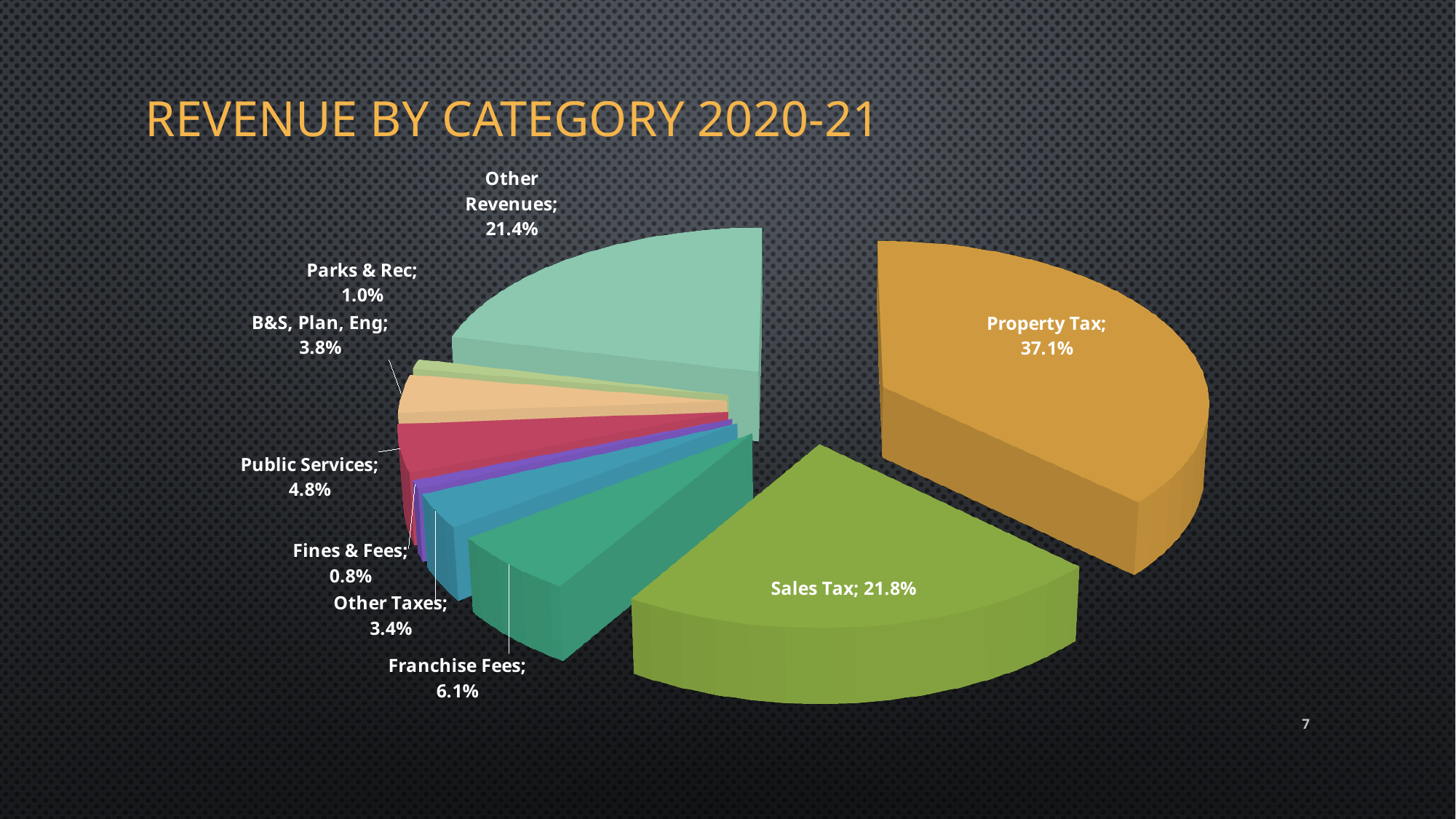
What percentage is shown for Public Services? 4.8% Which is larger, Sales Tax or Other Revenues? Sales Tax How many categories are shown in the pie chart? 9 What percentage is shown for Franchise Fees? 6.1% Which category has the largest share of revenue? Property Tax What is the difference in percentage points between Property Tax and Sales Tax? 15.3 What is the title of the chart? Revenue by Category 2020-21 Which category has the smallest share of revenue? Fines & Fees What type of chart is shown on the slide? Pie chart Which is larger, Other Taxes or B&S, Plan, Eng? B&S, Plan, Eng What share of revenue does Property Tax account for? 37.1% What is the value labelled for Other Revenues? 21.4%